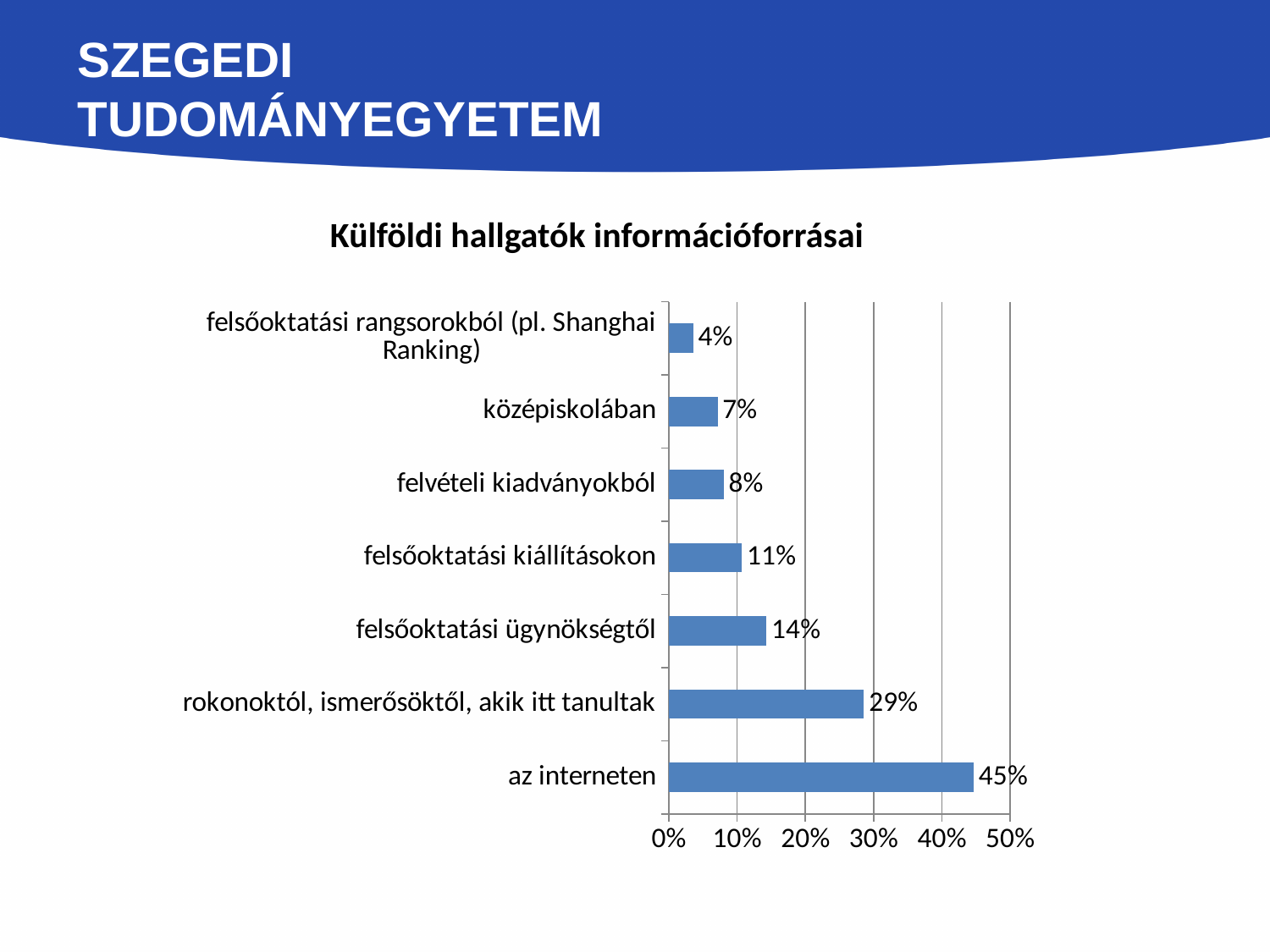
What is the value for "felsőoktatási ügynökségtől"? 14% What is the title of the chart? Külföldi hallgatók információforrásai Is the value for "rokonoktól, ismerősöktől, akik itt tanultak" greater or less than 20%? greater Which category has the highest value? az interneten Which category has the lowest value? felsőoktatási rangsorokból (pl. Shanghai Ranking) What is the value for "az interneten"? 45% Which is larger: the value for "felsőoktatási kiállításokon" or the value for "felvételi kiadványokból"? felsőoktatási kiállításokon What is the difference between the values for "az interneten" and "rokonoktól, ismerősöktől, akik itt tanultak"? 16% How many categories are shown in the chart? 7 What kind of chart is shown on the slide? bar chart What is the value for "középiskolában"? 7% What is the highest value shown on the x axis? 50%